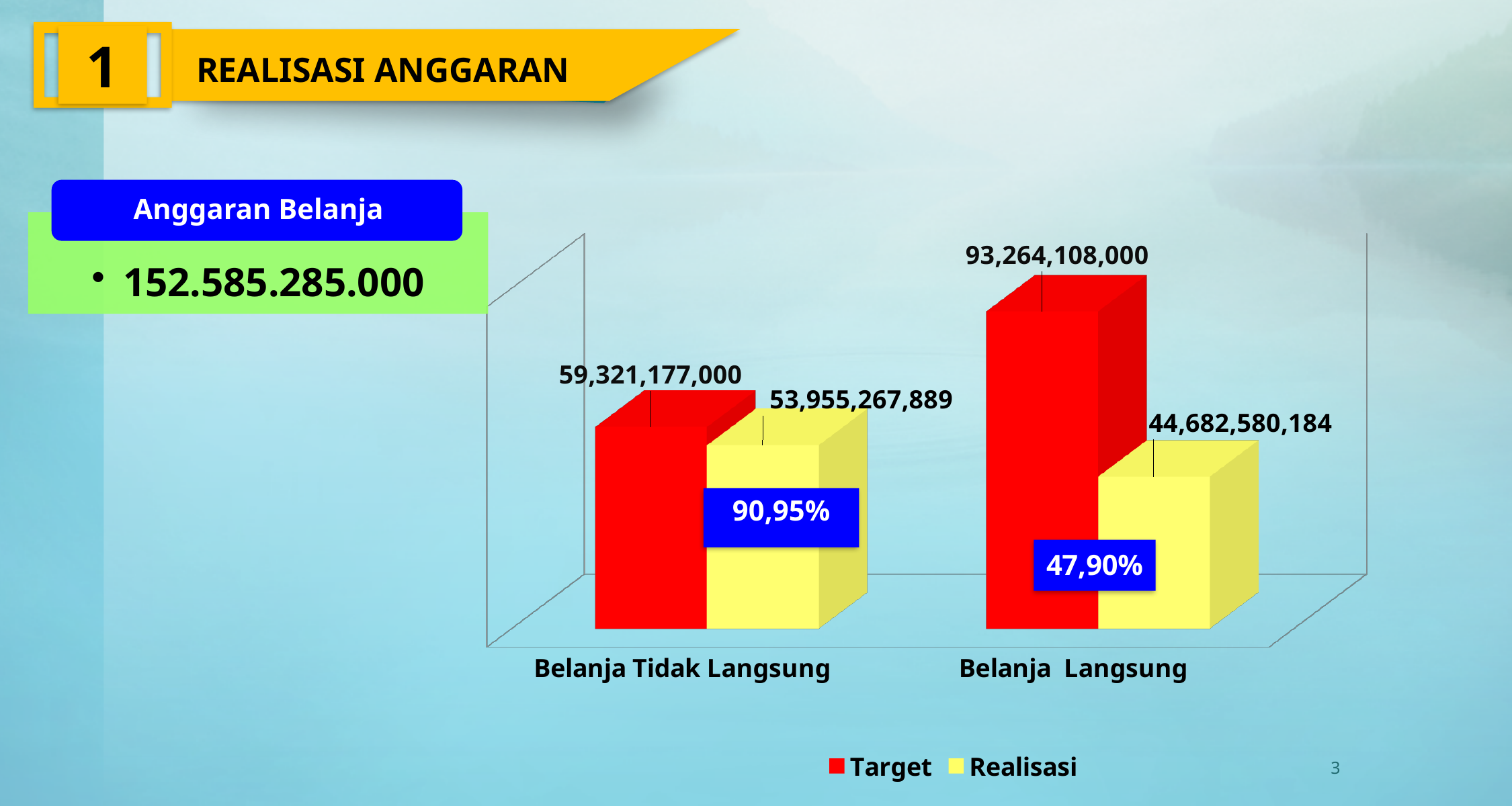
What is the Target value for Belanja Tidak Langsung? 59,321,177,000 What is the Realisasi value for Belanja Langsung? 44,682,580,184 How many series does the legend list? 2 Which category has the lowest Realisasi value? Belanja Langsung What is the Realisasi value for Belanja Tidak Langsung? 53,955,267,889 What is the Target value for Belanja Langsung? 93,264,108,000 Which category has the highest Target value? Belanja Langsung What is the difference between Target and Realisasi for Belanja Langsung? 48,581,527,816 Which is larger: the Realisasi for Belanja Tidak Langsung or the Realisasi for Belanja Langsung? Realisasi for Belanja Tidak Langsung What is the difference between Target and Realisasi for Belanja Tidak Langsung? 5,365,909,111 What percentage is shown on the blue label for Belanja Langsung? 47,90% What type of chart is shown on the slide? Bar chart